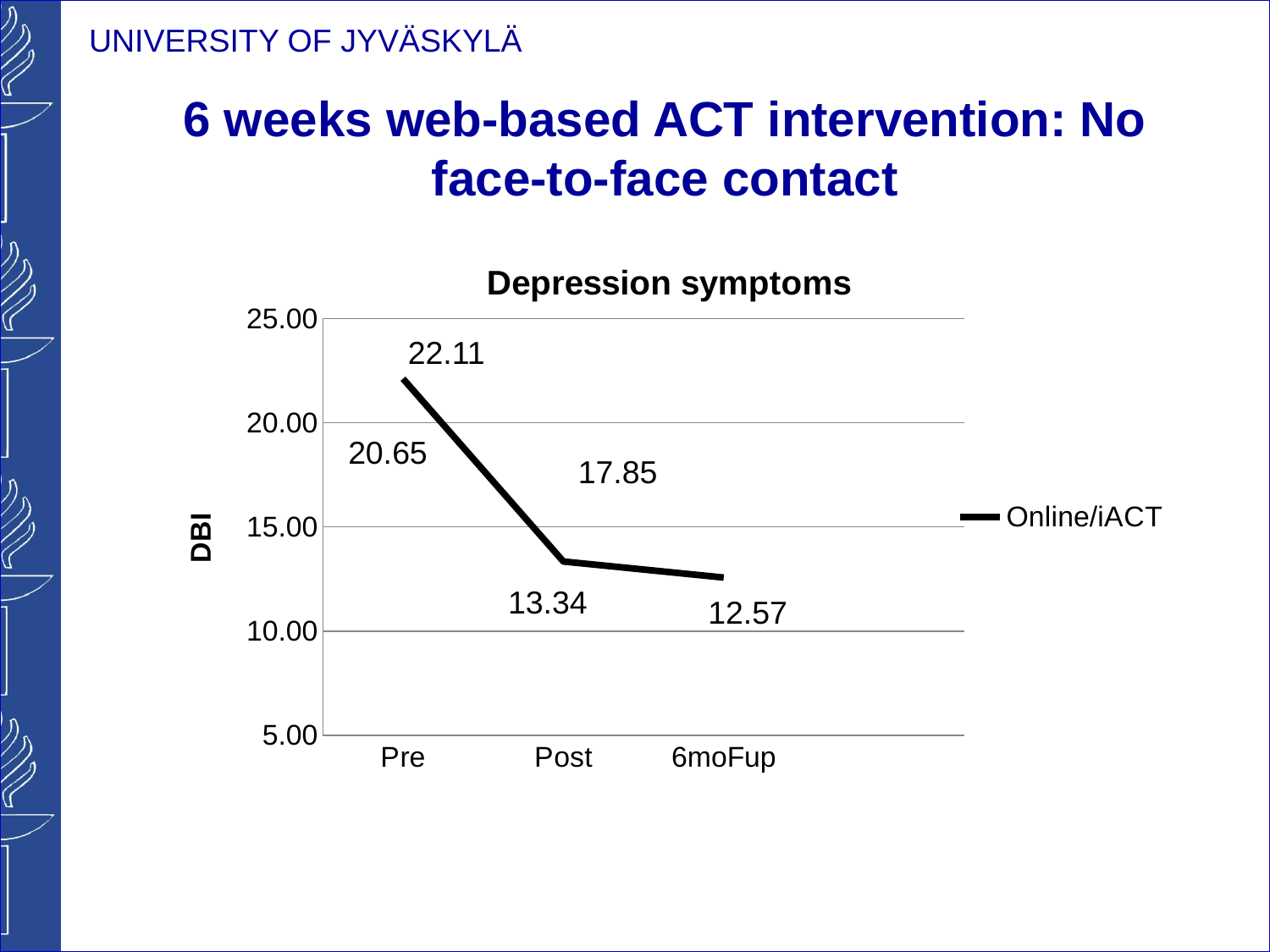
How many time points are plotted along the x axis? 3 At which time point is the DBI value lowest? 6moFup What is the DBI value at Post for Online/iACT? 13.34 At which time point is the DBI value highest? Pre What is the difference between the DBI values at Post and 6moFup? 0.77 Which has the larger DBI value, Post or 6moFup? Post What kind of chart is shown on the slide? line chart Do the DBI values rise or fall from Pre to 6moFup? fall What is the title of the chart? Depression symptoms How many series does the legend list? 1 Is the DBI value at Pre greater or less than 20.00? greater What is the DBI value at 6moFup for Online/iACT? 12.57